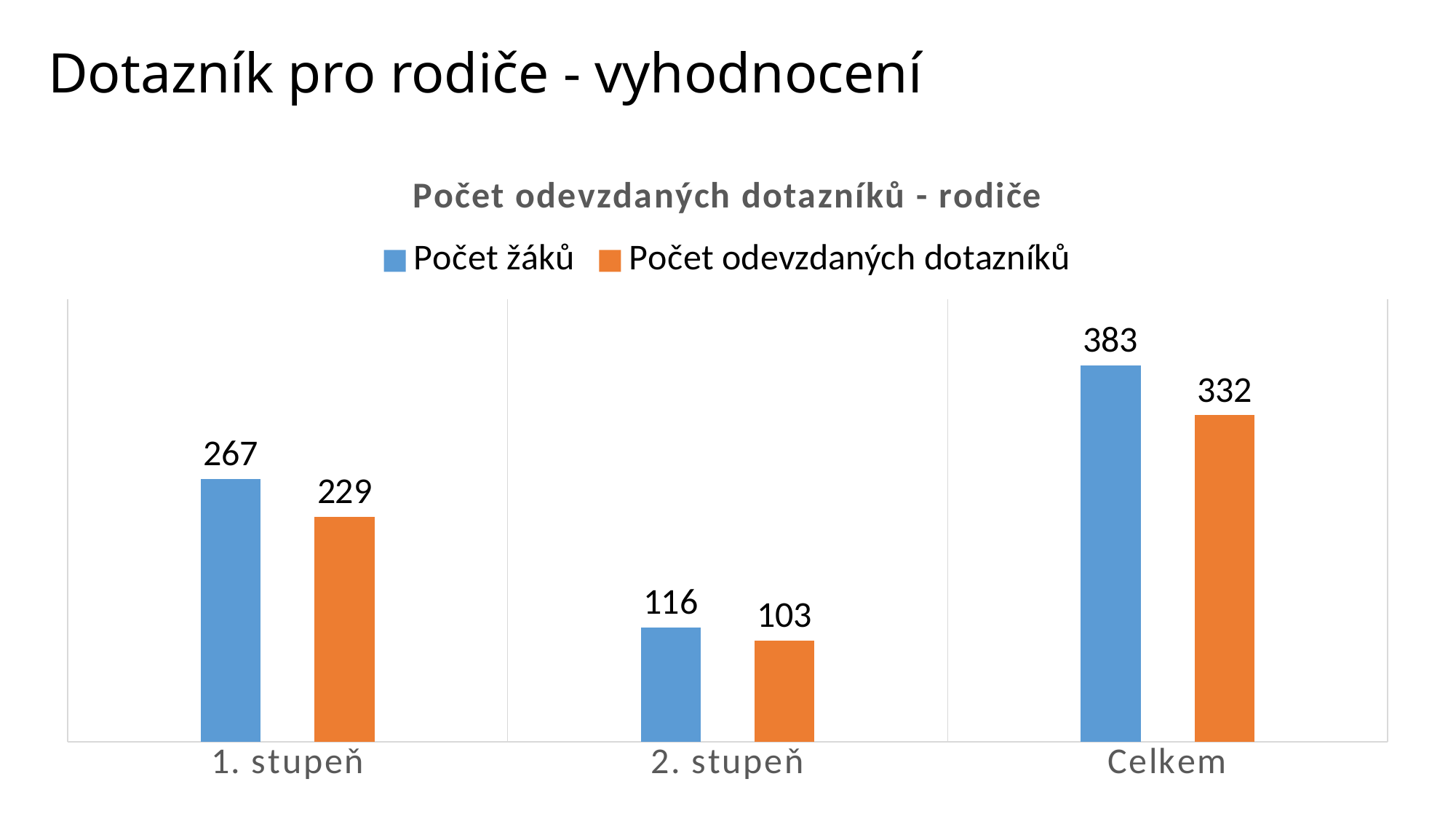
What is the title of the chart? Počet odevzdaných dotazníků - rodiče What is the value of Počet odevzdaných dotazníků for 2. stupeň? 103 What is the difference between Počet žáků and Počet odevzdaných dotazníků for 1. stupeň? 38 How many categories are shown on the x axis? 3 What is the value of Počet žáků for 1. stupeň? 267 Which category has the highest value for Počet žáků? Celkem Which category has the lowest value for Počet odevzdaných dotazníků? 2. stupeň What kind of chart is shown on the slide? Bar chart How many series does the legend list? 2 What is the difference between Počet žáků and Počet odevzdaných dotazníků for Celkem? 51 What is the value of Počet odevzdaných dotazníků for Celkem? 332 Which is larger: Počet odevzdaných dotazníků for 1. stupeň or Počet žáků for 2. stupeň? Počet odevzdaných dotazníků for 1. stupeň